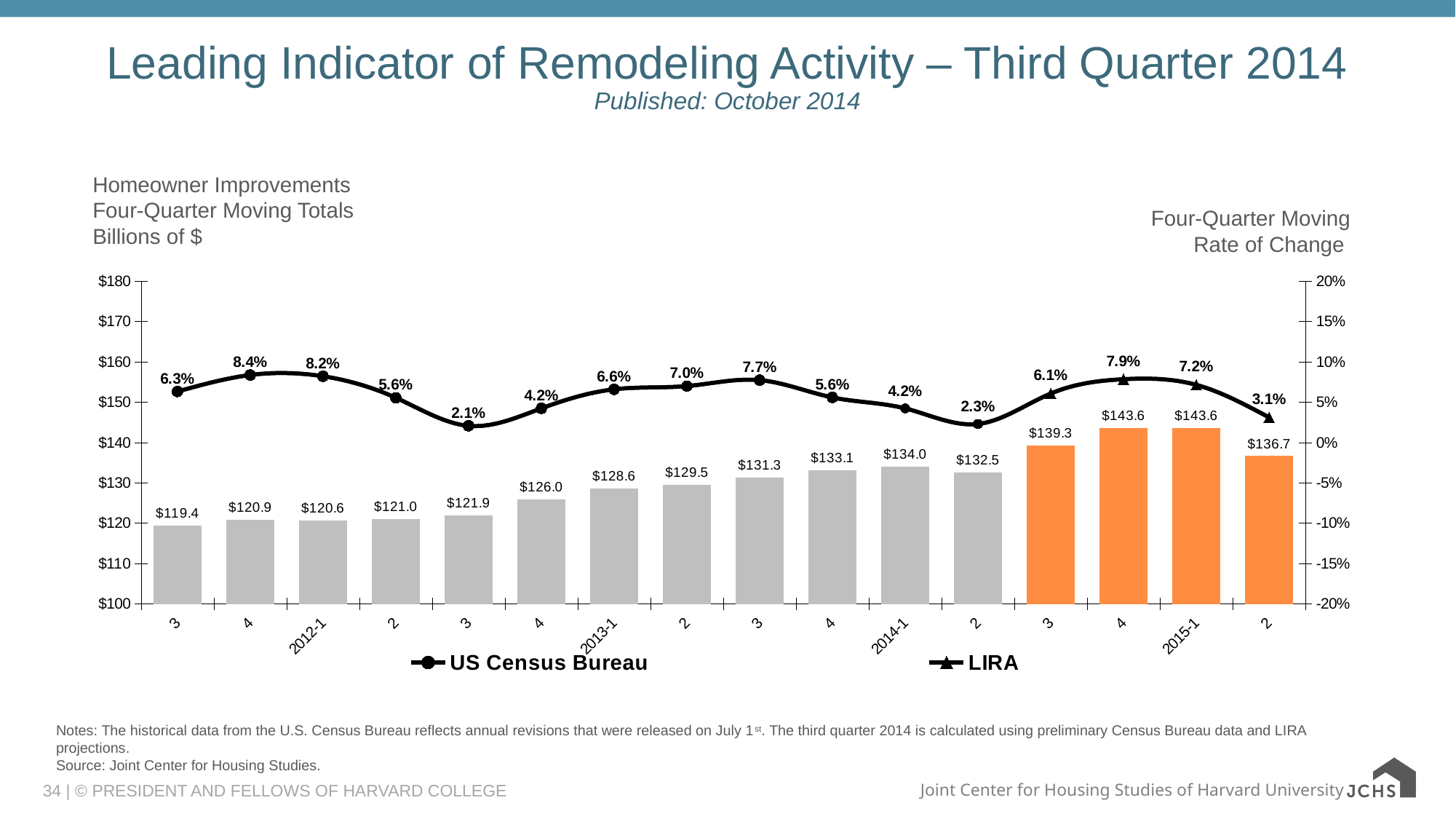
What is the lowest four-quarter moving total shown on the chart? $119.4 What is the four-quarter moving total shown for 2014-1? $134.0 What is the four-quarter moving total shown for the last bar on the right (labelled 2, after 2015-1)? $136.7 What is the four-quarter moving total shown for 2012-1? $120.6 What is the difference between the four-quarter moving totals for 2014-1 and 2013-1? $5.4 How many series does the legend list? 2 What rate of change is shown for 2015-1? 7.2% Which has the larger four-quarter moving total, 2015-1 or 2014-1? 2015-1 Which series does the legend show with triangle markers? LIRA How many bars are plotted on the chart? 16 What is the highest rate of change shown on the chart? 8.4% What rate of change is shown for 2013-1? 6.6%